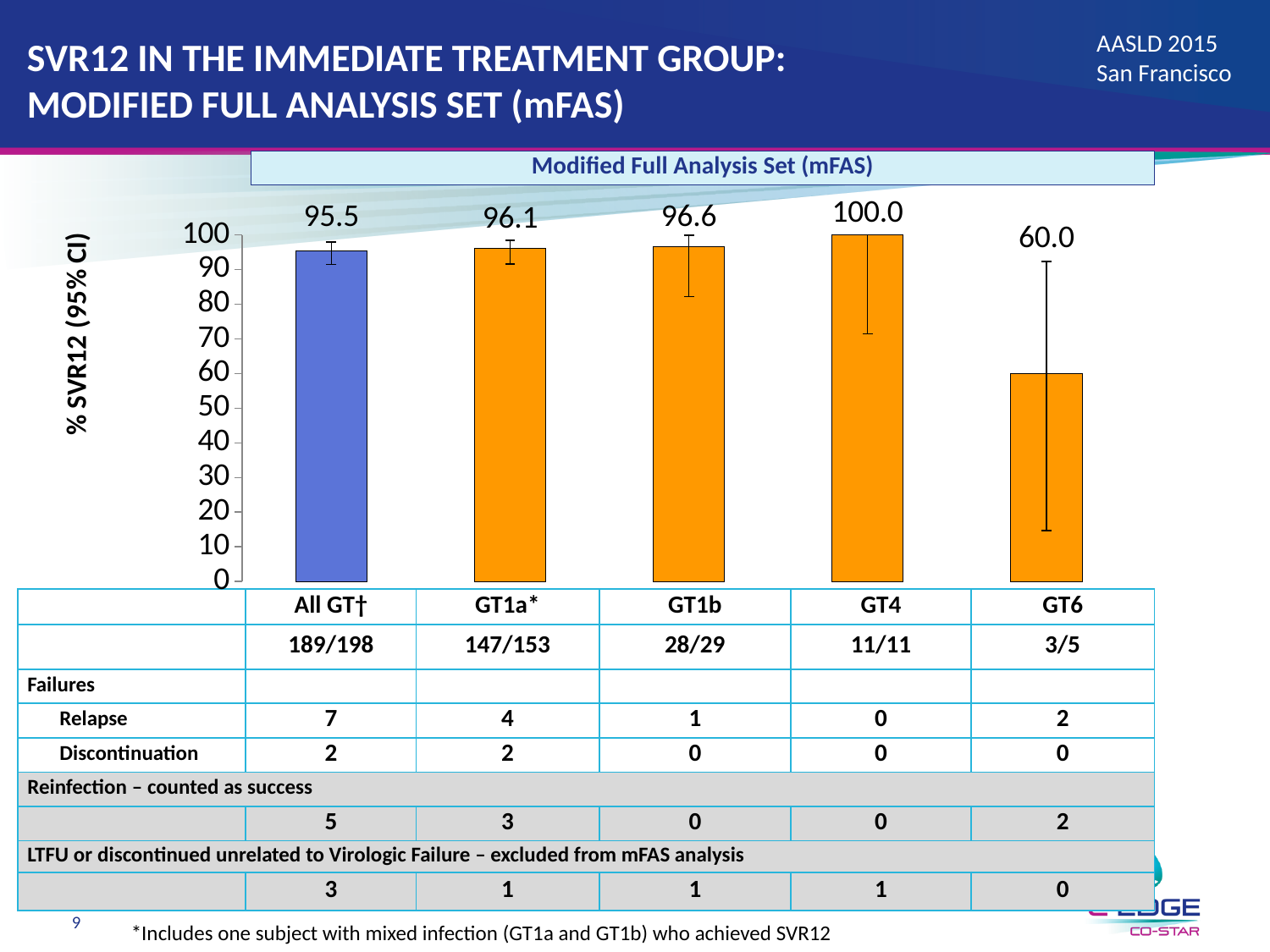
Which genotype group has the lowest % SVR12? GT6 What is the difference in % SVR12 between GT1a* and All GT†? 0.6 Which genotype group has the highest % SVR12? GT4 What is the title shown above the chart? Modified Full Analysis Set (mFAS) How many genotype groups are plotted in the chart? 5 What is the % SVR12 value for All GT†? 95.5 What is the % SVR12 value for GT6? 60.0 What type of chart is shown on the slide? bar chart What is the difference in % SVR12 between GT4 and GT6? 40.0 What is the % SVR12 value for GT1b? 96.6 Which has a higher % SVR12, GT1b or GT6? GT1b Is the value for GT6 greater or less than 70? less